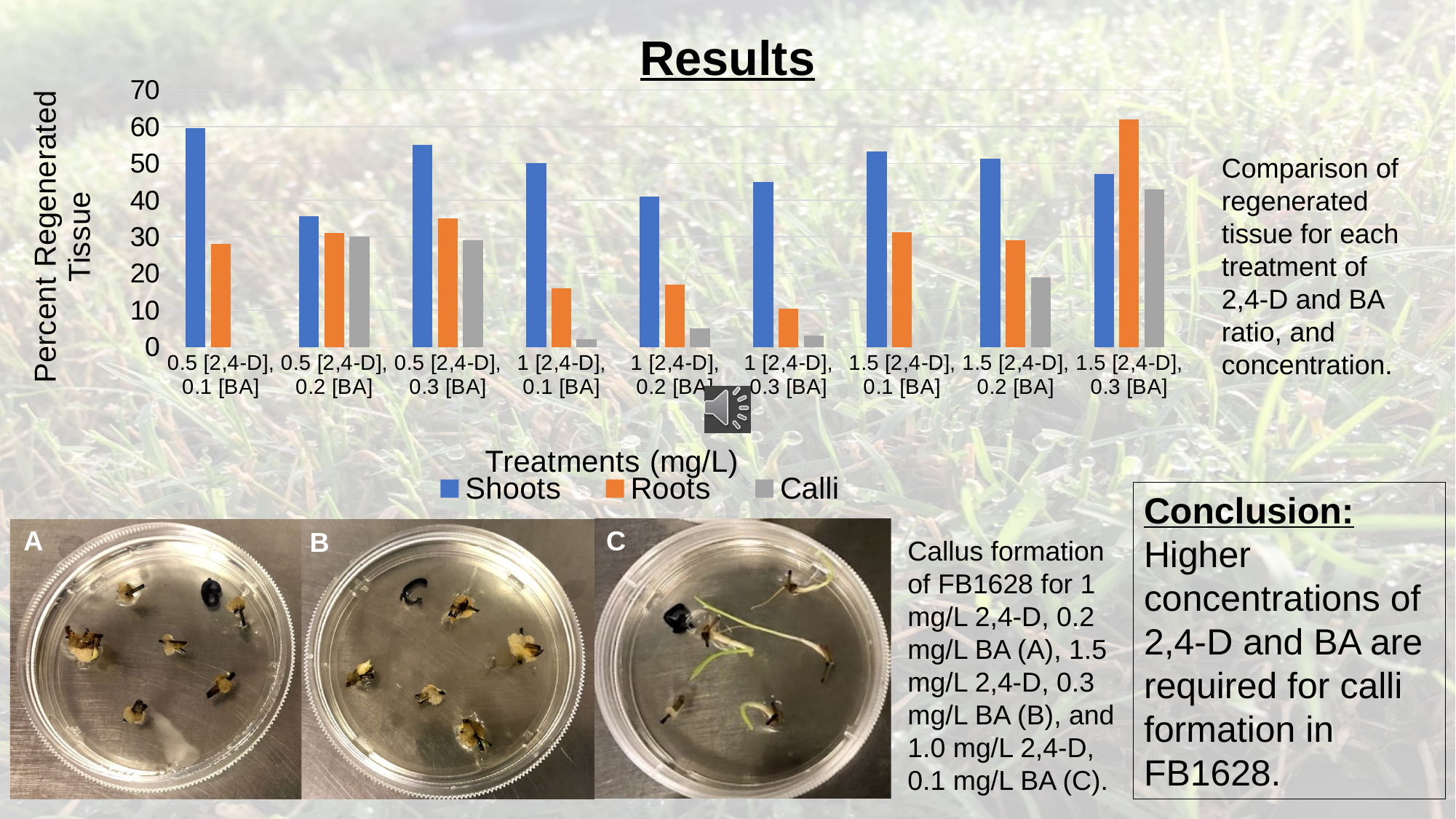
Which treatment has the highest Roots value? 1.5 [2,4-D], 0.3 [BA] What kind of chart is shown on the slide? Bar chart Is the Roots value for 1 [2,4-D], 0.1 [BA] greater or less than 20? less Which treatment has the lowest Roots value? 1 [2,4-D], 0.3 [BA] How many series does the chart legend list? 3 How many treatment categories are shown on the x axis of the chart? 9 Which treatment has the highest Calli value? 1.5 [2,4-D], 0.3 [BA] For the treatment 1.5 [2,4-D], 0.3 [BA], which is larger, the Shoots value or the Roots value? Roots Is the Shoots value for 0.5 [2,4-D], 0.1 [BA] greater or less than 50? greater Which treatment has the lowest Shoots value? 0.5 [2,4-D], 0.2 [BA] What is the title of the x axis of the chart? Treatments (mg/L) Which treatment has the highest Shoots value? 0.5 [2,4-D], 0.1 [BA]